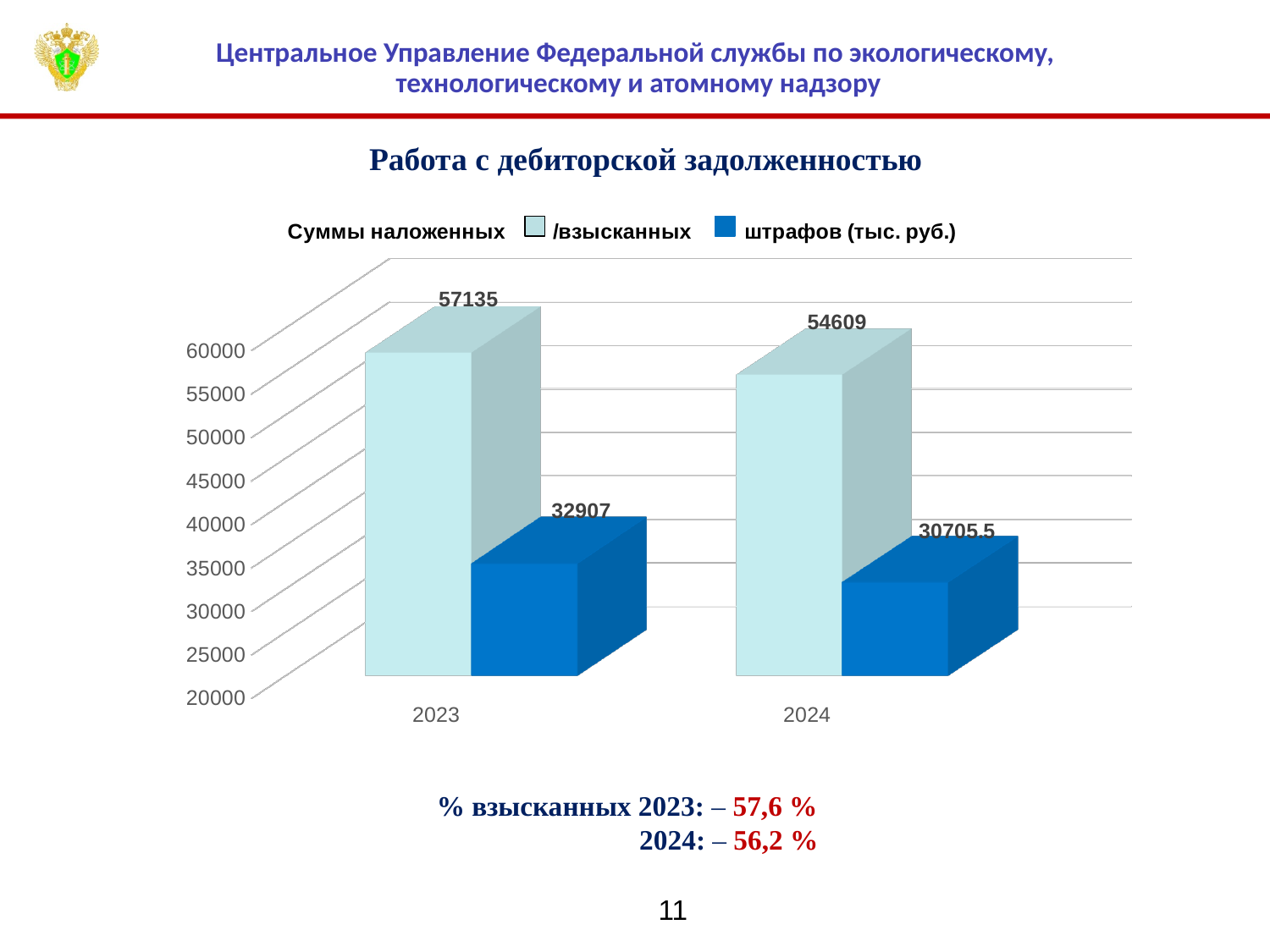
Is the collected fines value for 2023 larger or smaller than the collected fines value for 2024? larger What is the difference between imposed fines in 2023 and imposed fines in 2024? 2526 What is the value of the collected fines (взысканных) bar for 2024? 30705.5 How many years (categories) are shown on the x axis? 2 Which bar has the lowest value on the chart? Collected fines (взысканных) for 2024 What type of chart is shown on the slide? Bar chart What is the difference between imposed and collected fines in 2023? 24228 What is the value of the imposed fines (наложенных) bar for 2024? 54609 How many series does the legend list? 2 Which year has the higher value for imposed fines (наложенных)? 2023 What is the value of the collected fines (взысканных) bar for 2023? 32907 What is the value of the imposed fines (наложенных) bar for 2023? 57135